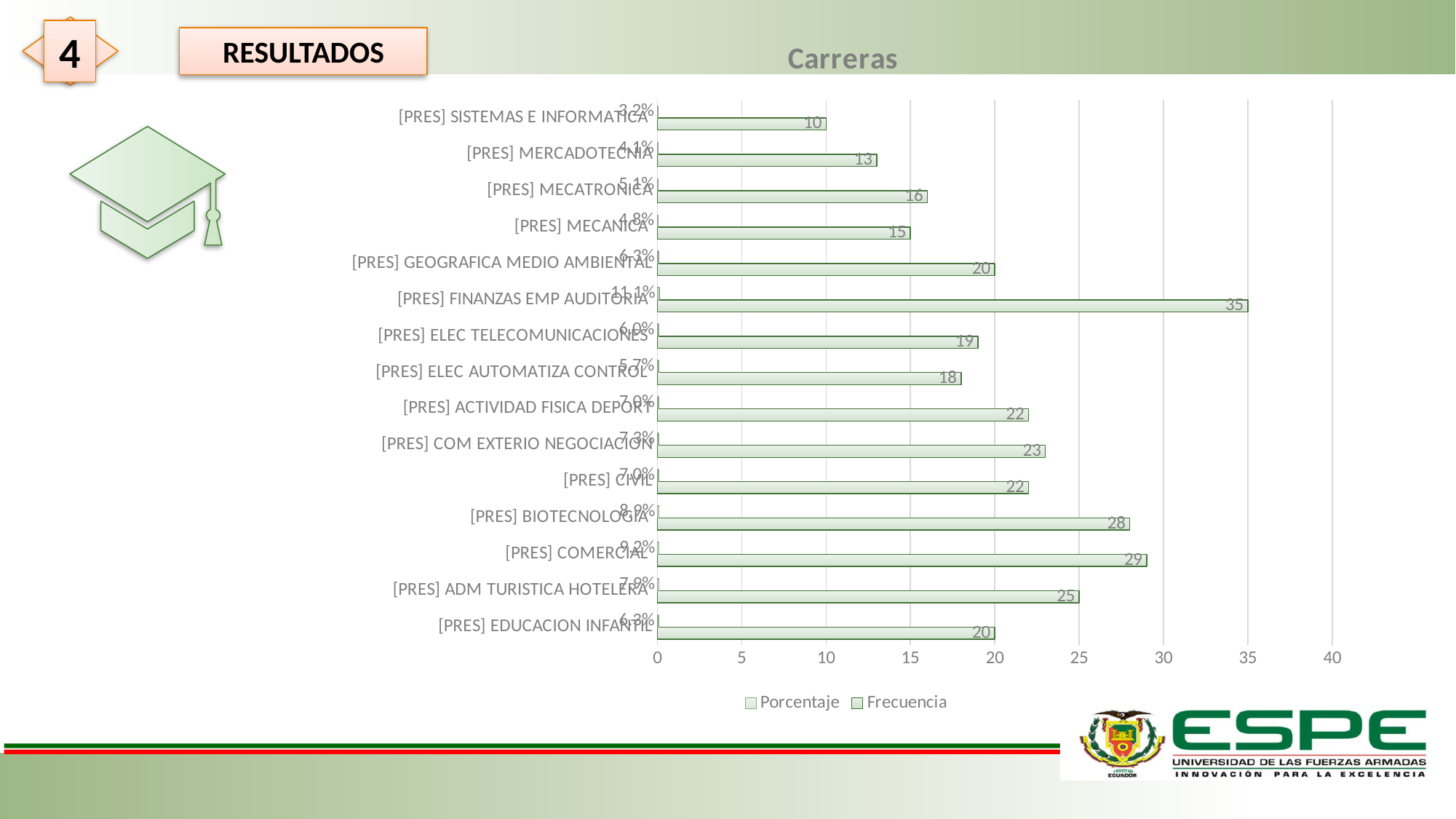
How many series does the legend list? 2 Is the Frecuencia value for [PRES] COM EXTERIO NEGOCIACION greater or less than 20? greater What is the Frecuencia value for [PRES] FINANZAS EMP AUDITORIA? 35 What kind of chart is shown on the slide? Bar chart What is the Frecuencia value for [PRES] COMERCIAL? 29 Which category has the highest Frecuencia value? [PRES] FINANZAS EMP AUDITORIA What is the Frecuencia value for [PRES] SISTEMAS E INFORMATICA? 10 What is the Frecuencia value for [PRES] ADM TURISTICA HOTELERA? 25 Which category has the lowest Frecuencia value? [PRES] SISTEMAS E INFORMATICA What is the difference between the Frecuencia values for [PRES] FINANZAS EMP AUDITORIA and [PRES] BIOTECNOLOGIA? 7 How many categories are shown on the chart? 15 Which has a larger Frecuencia value, [PRES] MECATRONICA or [PRES] MECANICA? [PRES] MECATRONICA